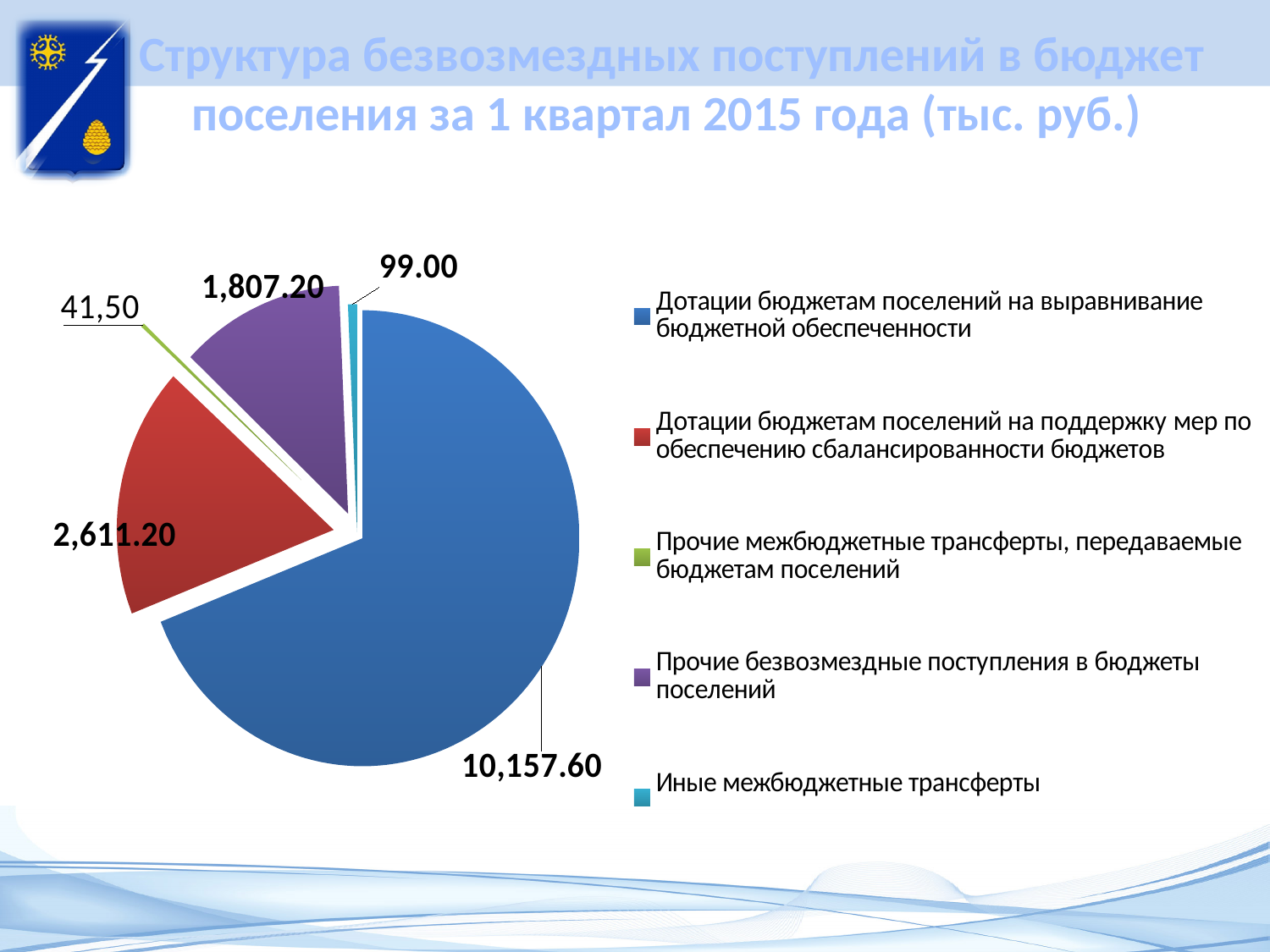
What is the value for "Дотации бюджетам поселений на поддержку мер по обеспечению сбалансированности бюджетов"? 2,611.20 What is the value for "Иные межбюджетные трансферты"? 99.00 What type of chart is shown on the slide? pie chart Which category has the smallest slice of the pie? Прочие межбюджетные трансферты, передаваемые бюджетам поселений What colour is the slice for "Прочие безвозмездные поступления в бюджеты поселений"? purple How many categories does the pie chart show? 5 What is the difference between the values for "Дотации бюджетам поселений на выравнивание бюджетной обеспеченности" and "Дотации бюджетам поселений на поддержку мер по обеспечению сбалансированности бюджетов"? 7,546.40 Which is larger: the value for "Дотации бюджетам поселений на поддержку мер по обеспечению сбалансированности бюджетов" or for "Прочие безвозмездные поступления в бюджеты поселений"? Дотации бюджетам поселений на поддержку мер по обеспечению сбалансированности бюджетов What is the value for "Дотации бюджетам поселений на выравнивание бюджетной обеспеченности"? 10,157.60 What is the value for "Прочие безвозмездные поступления в бюджеты поселений"? 1,807.20 Which category has the largest slice of the pie? Дотации бюджетам поселений на выравнивание бюджетной обеспеченности What is the value for "Прочие межбюджетные трансферты, передаваемые бюджетам поселений"? 41,50